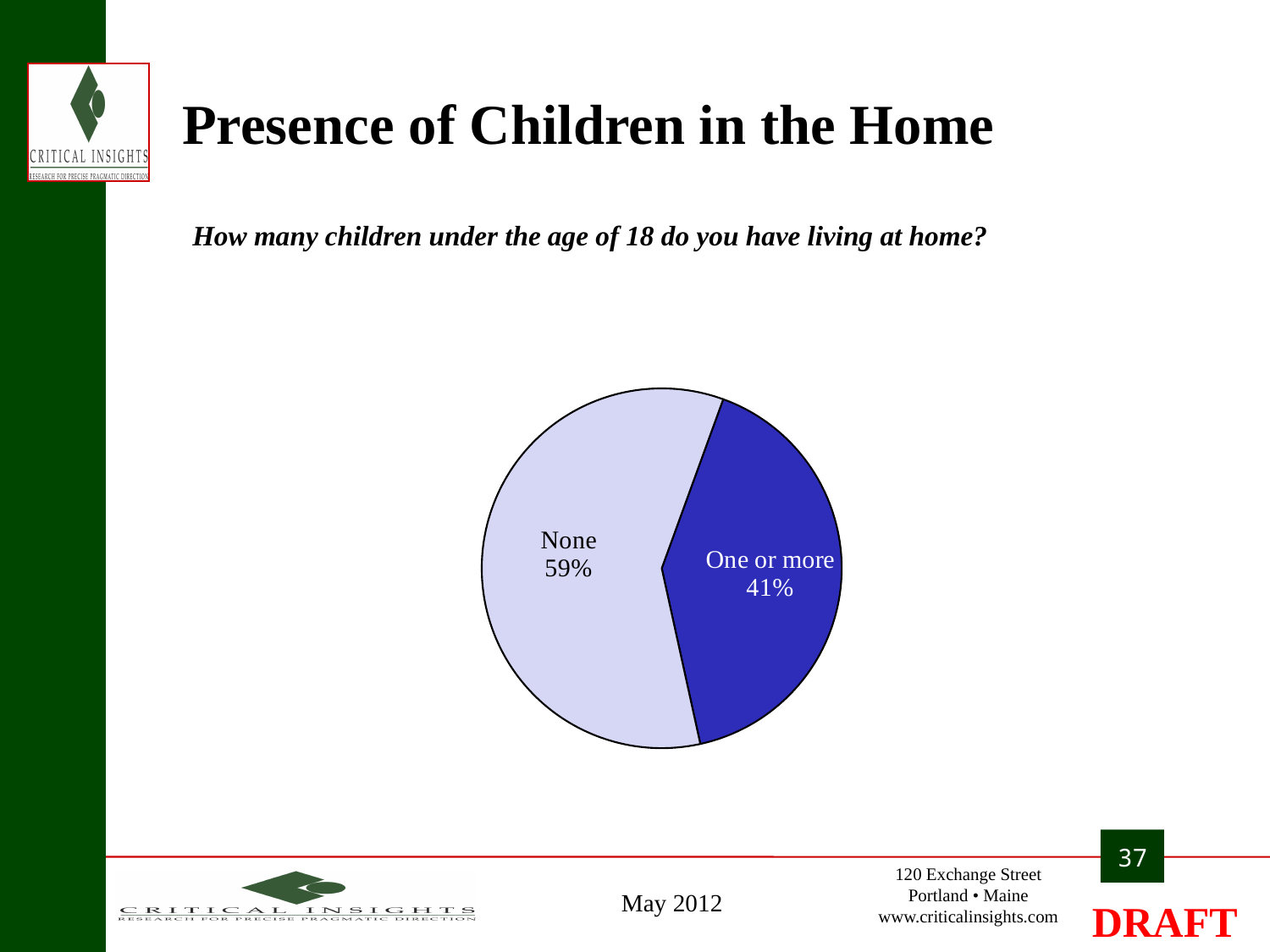
Which slice of the pie is the smallest? One or more What percentage of respondents have no children under 18 living at home? 59% What share of the pie does the 'One or more' slice represent? 41% How many slices does the pie chart have? 2 What is the title of the slide containing the pie chart? Presence of Children in the Home Which is larger, the share for 'None' or the share for 'One or more'? None What kind of chart is shown on the slide? pie chart What percentage of respondents have one or more children under 18 living at home? 41% Which slice of the pie is coloured dark blue? One or more Which slice of the pie is the largest? None What is the difference in percentage points between the 'None' slice and the 'One or more' slice? 18